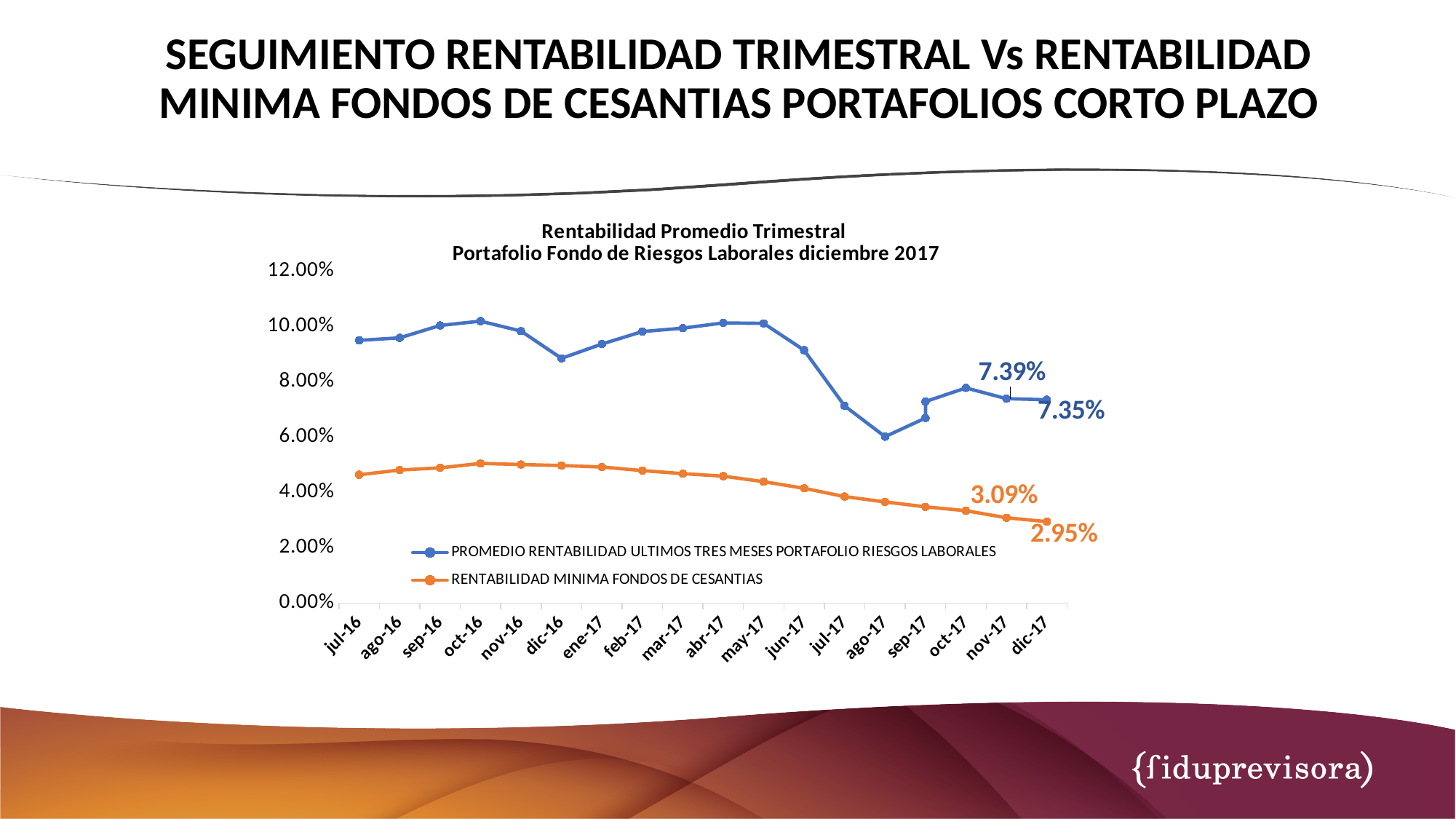
Which series has the higher value for dic-17? PROMEDIO RENTABILIDAD ULTIMOS TRES MESES PORTAFOLIO RIESGOS LABORALES Does the RENTABILIDAD MINIMA FONDOS DE CESANTIAS series rise or fall from oct-16 to dic-17? fall What kind of chart is shown on the slide? line chart What colour is the line for RENTABILIDAD MINIMA FONDOS DE CESANTIAS? orange What is the value of RENTABILIDAD MINIMA FONDOS DE CESANTIAS for dic-17? 2.95% What is the difference between the two series' values for dic-17? 4.40% What is the value of PROMEDIO RENTABILIDAD ULTIMOS TRES MESES PORTAFOLIO RIESGOS LABORALES for dic-17? 7.35% In which month is PROMEDIO RENTABILIDAD ULTIMOS TRES MESES PORTAFOLIO RIESGOS LABORALES at its lowest? ago-17 What is the value of RENTABILIDAD MINIMA FONDOS DE CESANTIAS for nov-17? 3.09% Is the value of PROMEDIO RENTABILIDAD ULTIMOS TRES MESES PORTAFOLIO RIESGOS LABORALES for ago-17 greater or less than 8.00%? less How many months are plotted along the x axis? 18 How many series does the legend list? 2